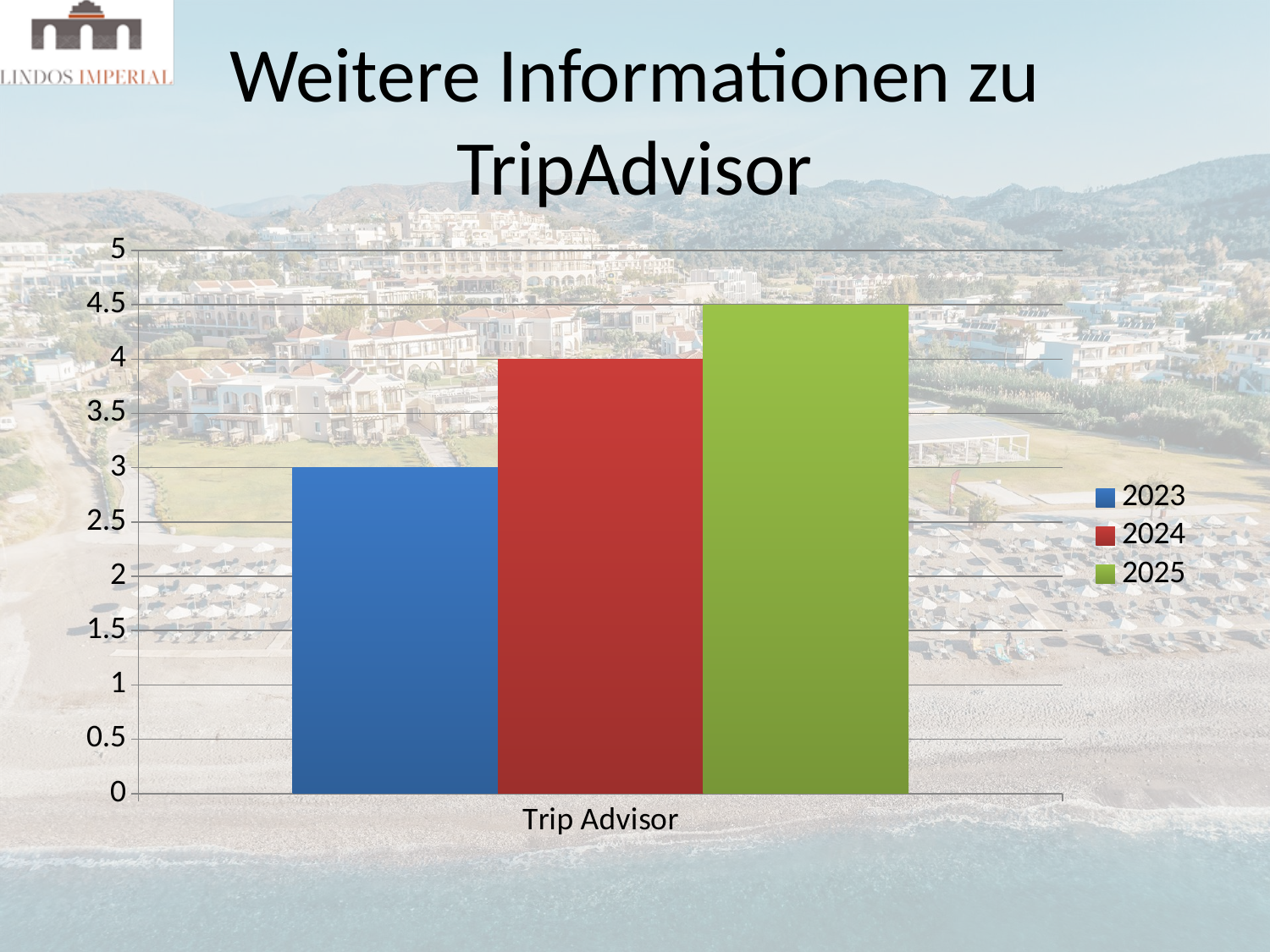
Which year has the lowest value? 2023 What is the value for 2023 in the Trip Advisor category? 3 Which year has the highest value? 2025 What kind of chart is shown on the slide? bar chart Which is larger, the value for 2024 or the value for 2023? 2024 What is the difference between the 2025 value and the 2023 value? 1.5 How many series does the legend list? 3 What is the value for 2024 in the Trip Advisor category? 4 What is the value for 2025 in the Trip Advisor category? 4.5 How many categories are shown on the x axis? 1 Is the value for 2025 greater or less than 4? greater Which colour represents the 2024 series in the legend? red